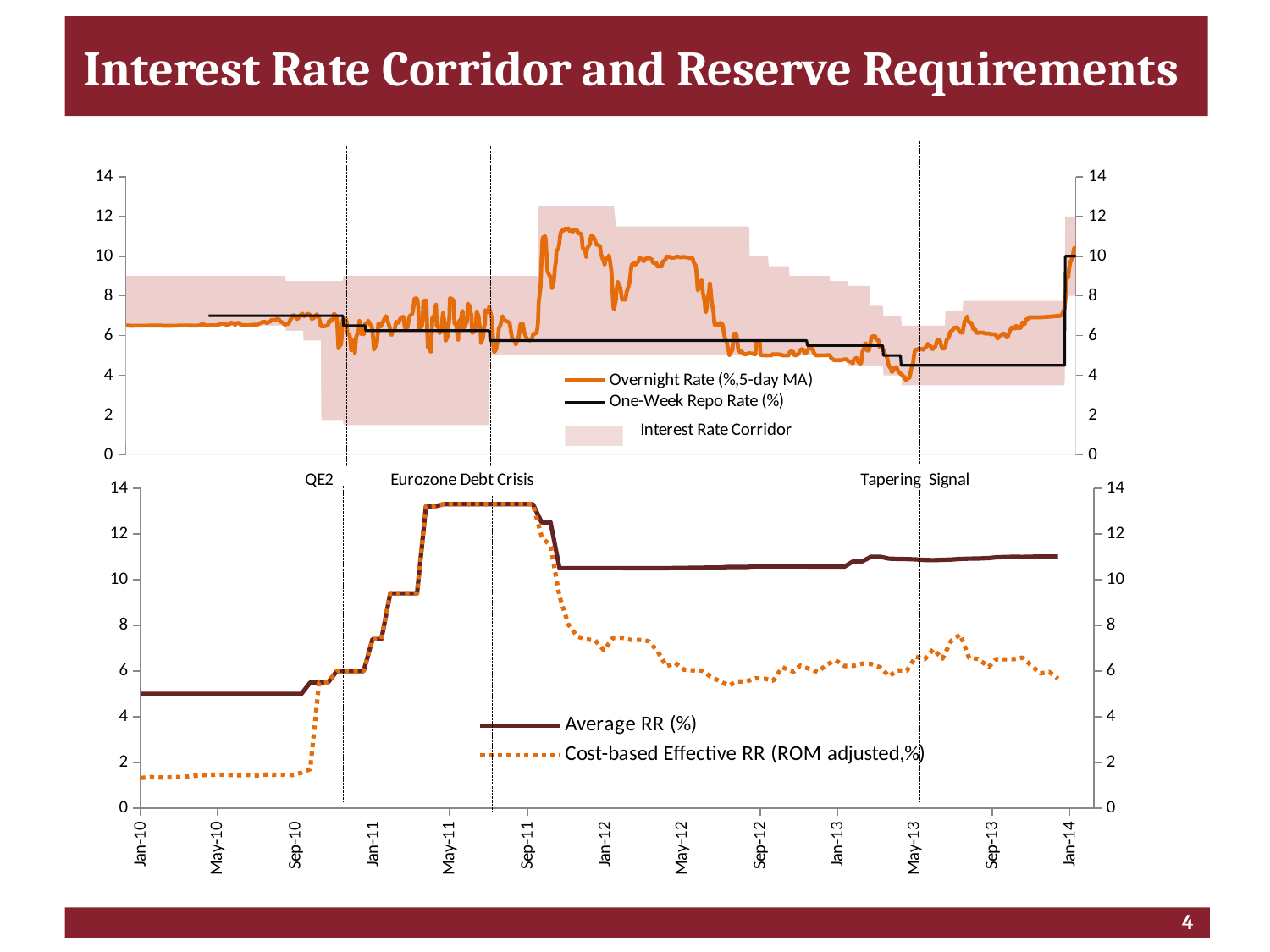
In the bottom chart, is the value of Average RR (%) at Jan-10 greater or less than 4? greater In the top chart, is the Overnight Rate (%,5-day MA) at Jan-12 greater or less than 8? greater What kind of chart is the bottom chart on the slide? line chart In the bottom chart, is the value of Cost-based Effective RR (ROM adjusted,%) at Jan-10 greater or less than 2? less In the bottom chart, does Cost-based Effective RR (ROM adjusted,%) rise or fall between Sep-11 and Jan-12? fall How many entries does the legend of the top chart list? 3 How many series does the legend of the bottom chart list? 2 In the bottom chart, does Average RR (%) rise or fall between Jan-10 and May-11? rise What kind of chart is the top chart on the slide? line chart What event label is shown at the first vertical dashed line between the two charts? QE2